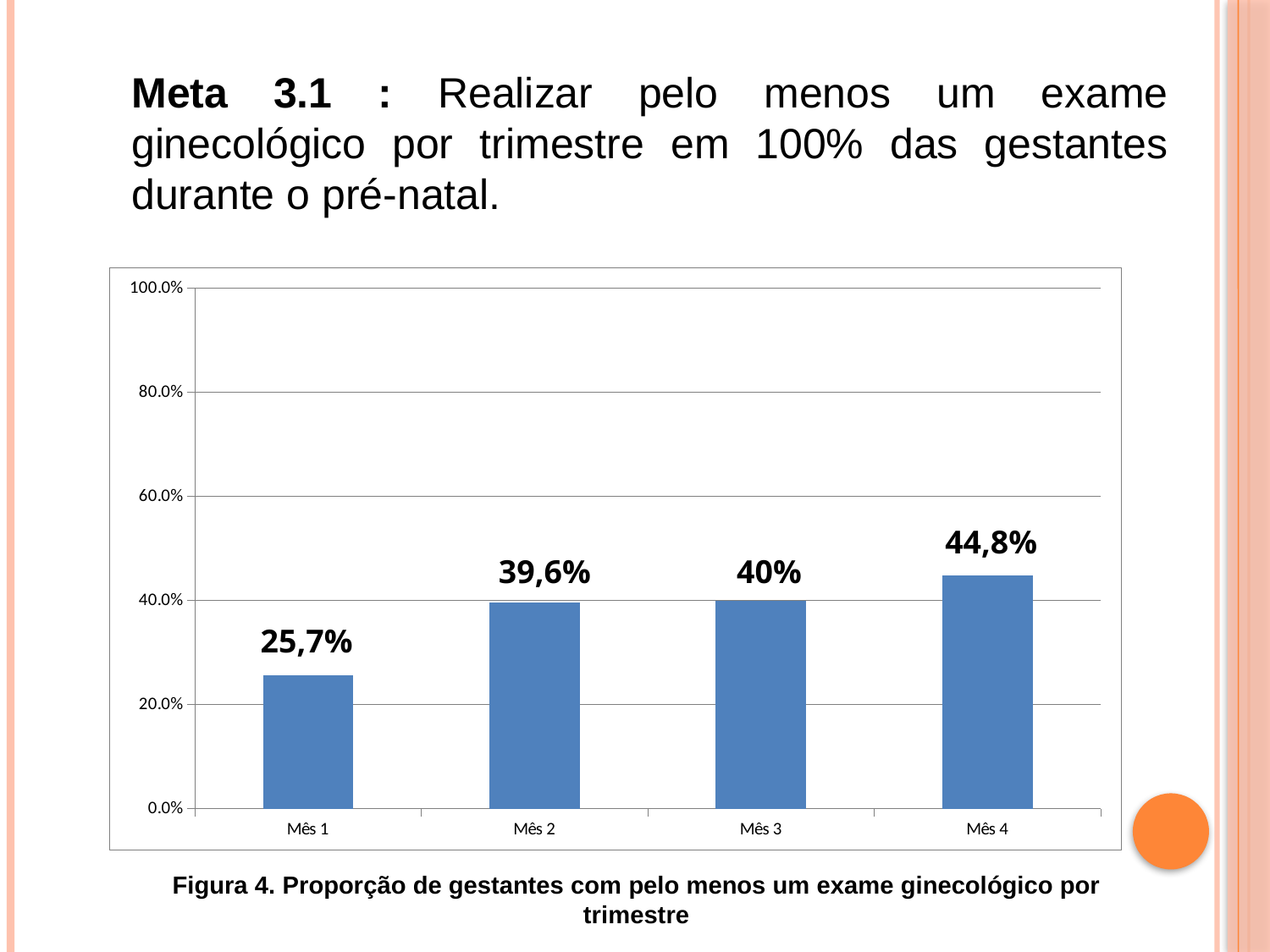
What is the value for Mês 4? 44,8% What is the difference between the values for Mês 4 and Mês 1? 19,1% Is the value for Mês 1 greater or less than 40.0%? less What is the value for Mês 2? 39,6% How many months are shown on the x axis? 4 Which is larger, the value for Mês 4 or the value for Mês 2? Mês 4 Which month has the lowest proportion? Mês 1 What is the value for Mês 3? 40% Do the values rise or fall from Mês 1 to Mês 4? rise What kind of chart is shown on the slide? bar chart What is the value for Mês 1? 25,7% Which month has the highest proportion? Mês 4